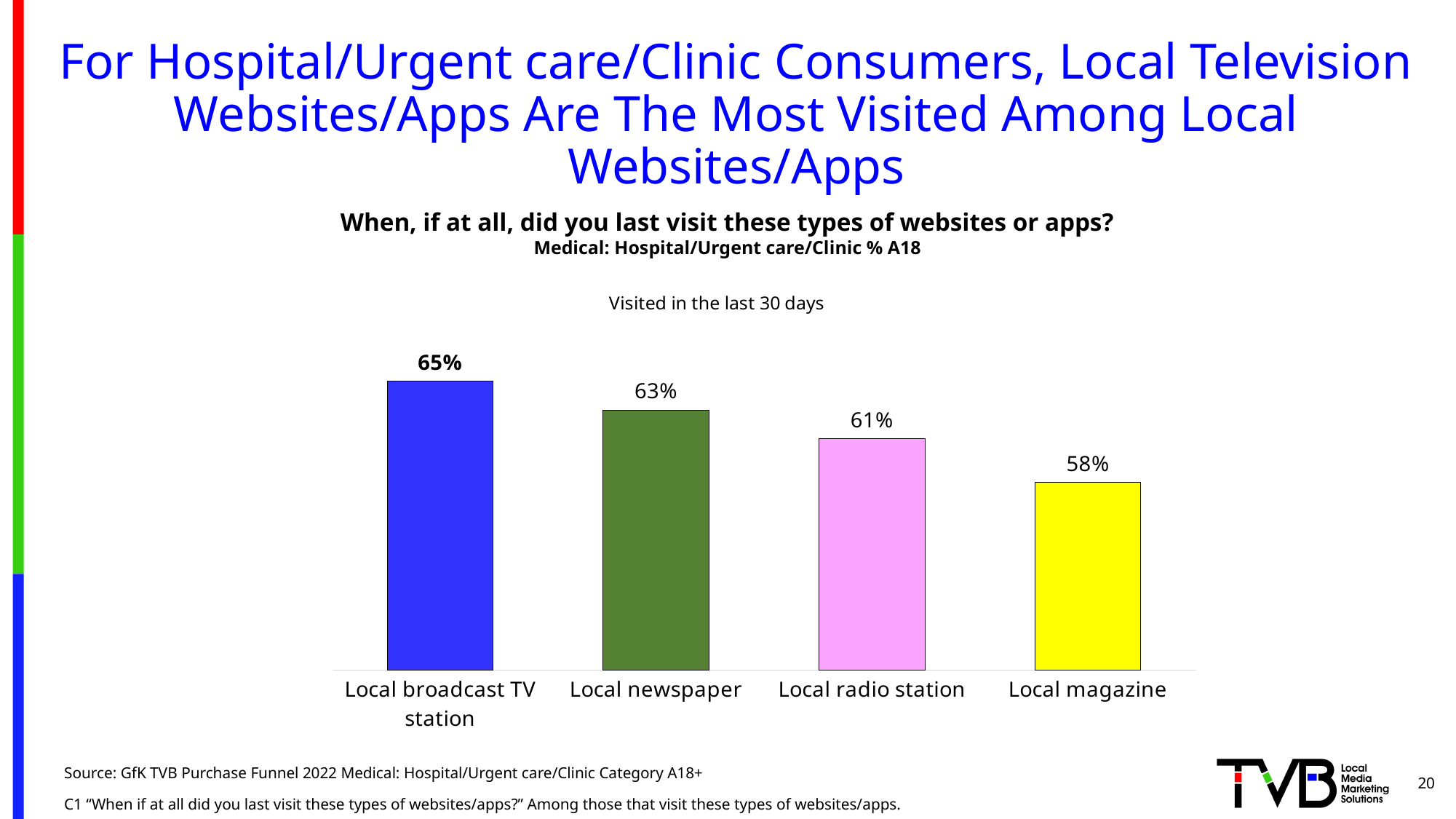
What is the value shown for Local magazine? 58% How many categories are shown in the chart? 4 What kind of chart is shown on the slide? Bar chart Which category has the highest value in the chart? Local broadcast TV station What is the difference in percentage points between Local newspaper and Local radio station? 2 Which is larger, the value for Local newspaper or the value for Local magazine? Local newspaper What is the value shown for Local radio station? 61% Which category has the lowest value in the chart? Local magazine What percentage of Hospital/Urgent care/Clinic consumers visited a local broadcast TV station website or app in the last 30 days? 65% What is the value shown for Local newspaper? 63% Do the values rise or fall moving from left to right across the categories? Fall What is the difference in percentage points between Local broadcast TV station and Local magazine? 7